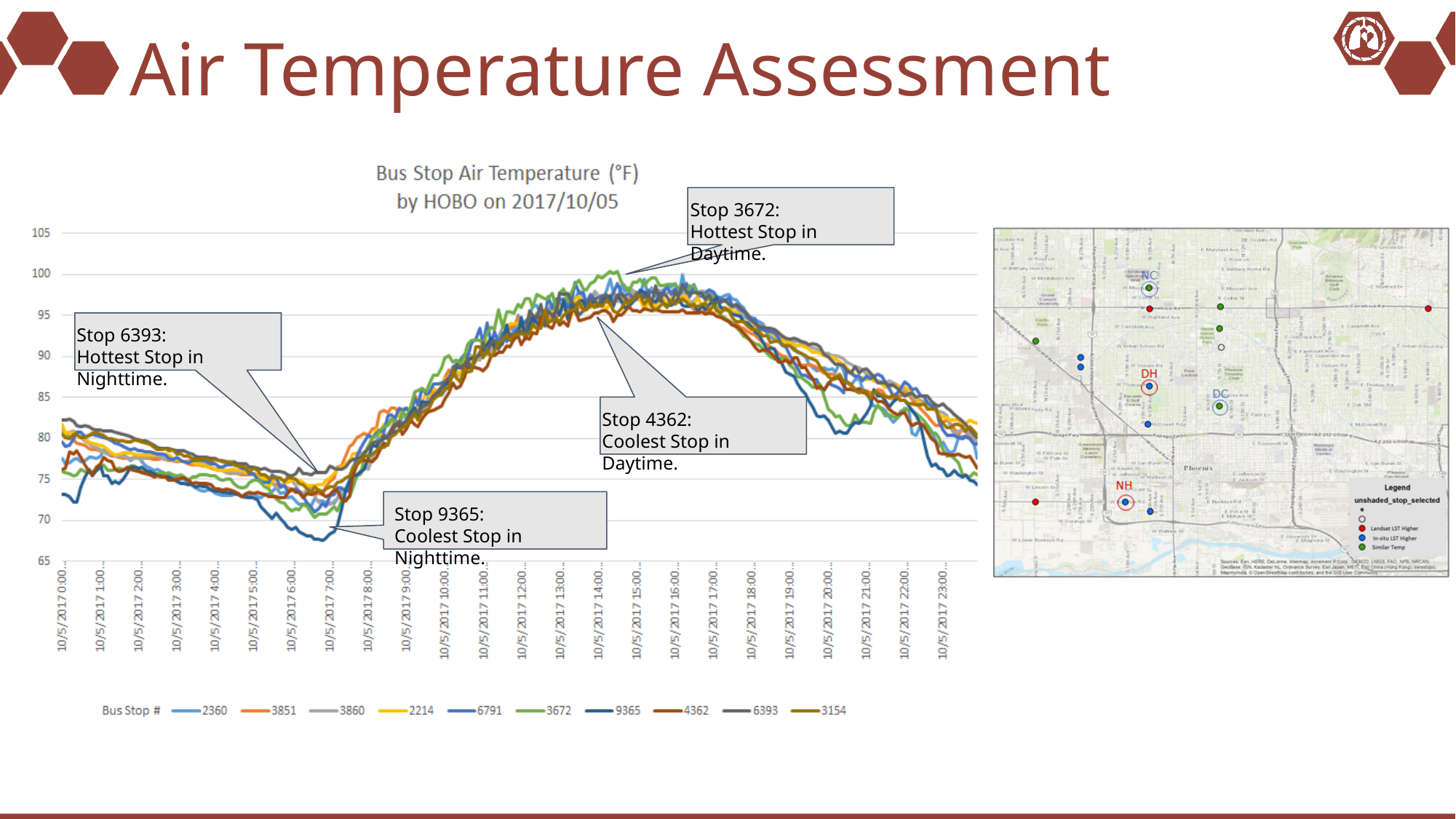
In the Bus Stop Air Temperature chart, do the temperatures rise or fall between 8:00 and 14:00? rise In the Bus Stop Air Temperature chart, do the temperatures rise or fall between 16:00 and 23:00? fall What is the title of the chart on the left of the slide? Bus Stop Air Temperature (°F) by HOBO on 2017/10/05 How many bus stop series does the legend of the Bus Stop Air Temperature chart list? 10 According to the annotation on the Bus Stop Air Temperature chart, which stop is the coolest in daytime? Stop 4362 According to the annotation on the Bus Stop Air Temperature chart, which stop is the coolest in nighttime? Stop 9365 In the Bus Stop Air Temperature chart, is the peak value for stop 3672 around 14:00 greater or less than 95? greater What kind of chart is the Bus Stop Air Temperature chart? line chart In the Bus Stop Air Temperature chart, is the lowest value for stop 9365 around 7:00 greater or less than 70? less What label precedes the series entries in the legend of the Bus Stop Air Temperature chart? Bus Stop # According to the annotation on the Bus Stop Air Temperature chart, which stop is the hottest in nighttime? Stop 6393 According to the annotation on the Bus Stop Air Temperature chart, which stop is the hottest in daytime? Stop 3672